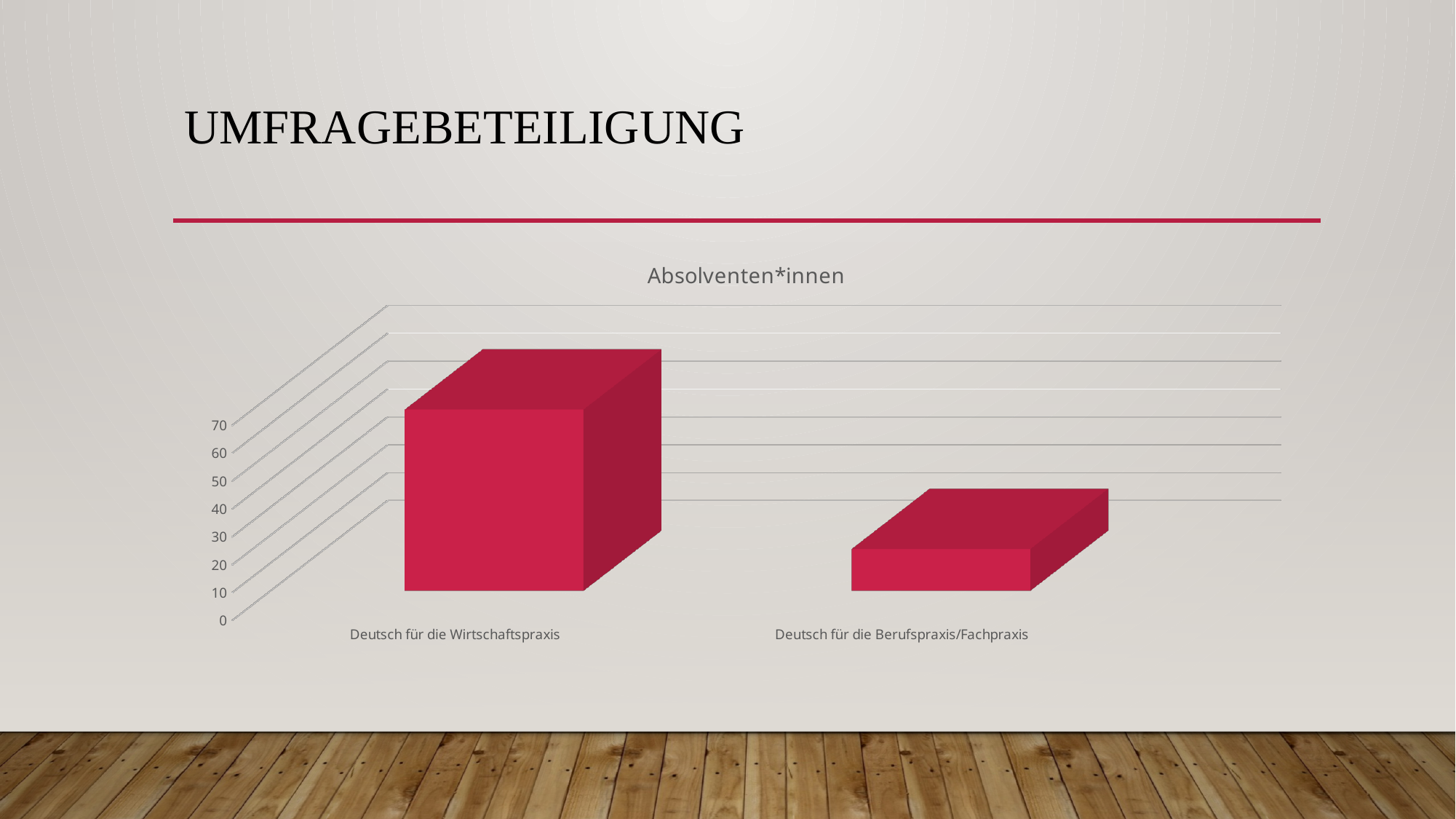
Do the values rise or fall from the left category to the right category? fall What type of chart is shown on the slide? bar chart Which category has the highest value? Deutsch für die Wirtschaftspraxis Is the value for Deutsch für die Wirtschaftspraxis greater or less than 40? greater What is the highest value shown on the vertical axis? 70 What is the title of the chart? Absolventen*innen Is the value for Deutsch für die Berufspraxis/Fachpraxis greater or less than 30? less Which is larger, the value for Deutsch für die Wirtschaftspraxis or the value for Deutsch für die Berufspraxis/Fachpraxis? Deutsch für die Wirtschaftspraxis Is the value for Deutsch für die Wirtschaftspraxis greater or less than 50? greater Which category has the lowest value? Deutsch für die Berufspraxis/Fachpraxis How many categories are shown in the chart? 2